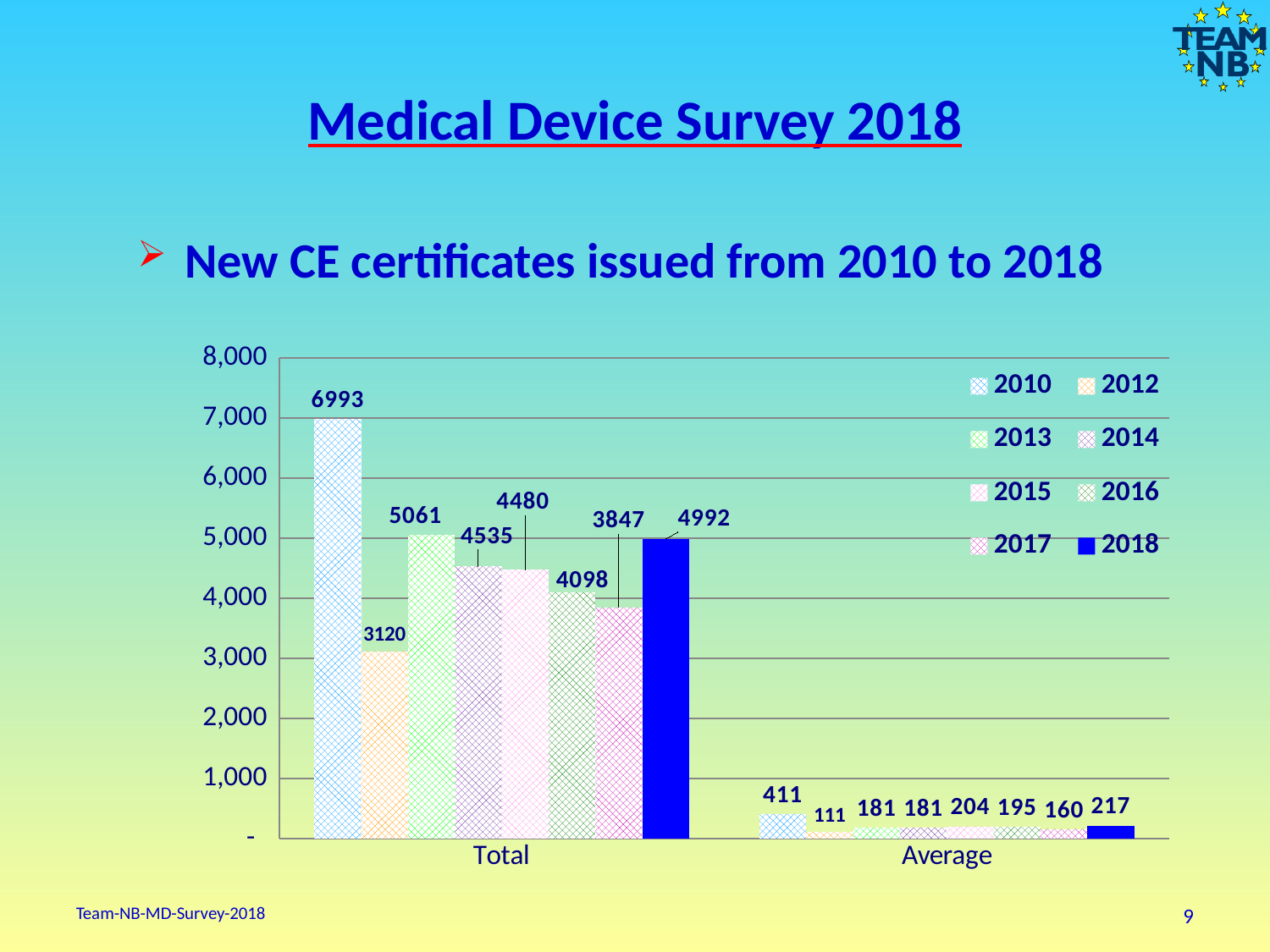
What is the difference between the Total values for 2010 and 2018? 2001 What is the Average value for 2012? 111 What kind of chart is shown on the slide? bar chart Which is larger, the Total value for 2013 or the Total value for 2018? 2013 Is the Total value for 2017 greater or less than 4,000? less How many series does the legend list? 8 Which year has the highest Average value? 2010 Which year has the highest Total value? 2010 What is the Total value for 2018? 4992 How many categories are shown on the x axis? 2 What is the Total value for 2010? 6993 Which year has the lowest Total value? 2012